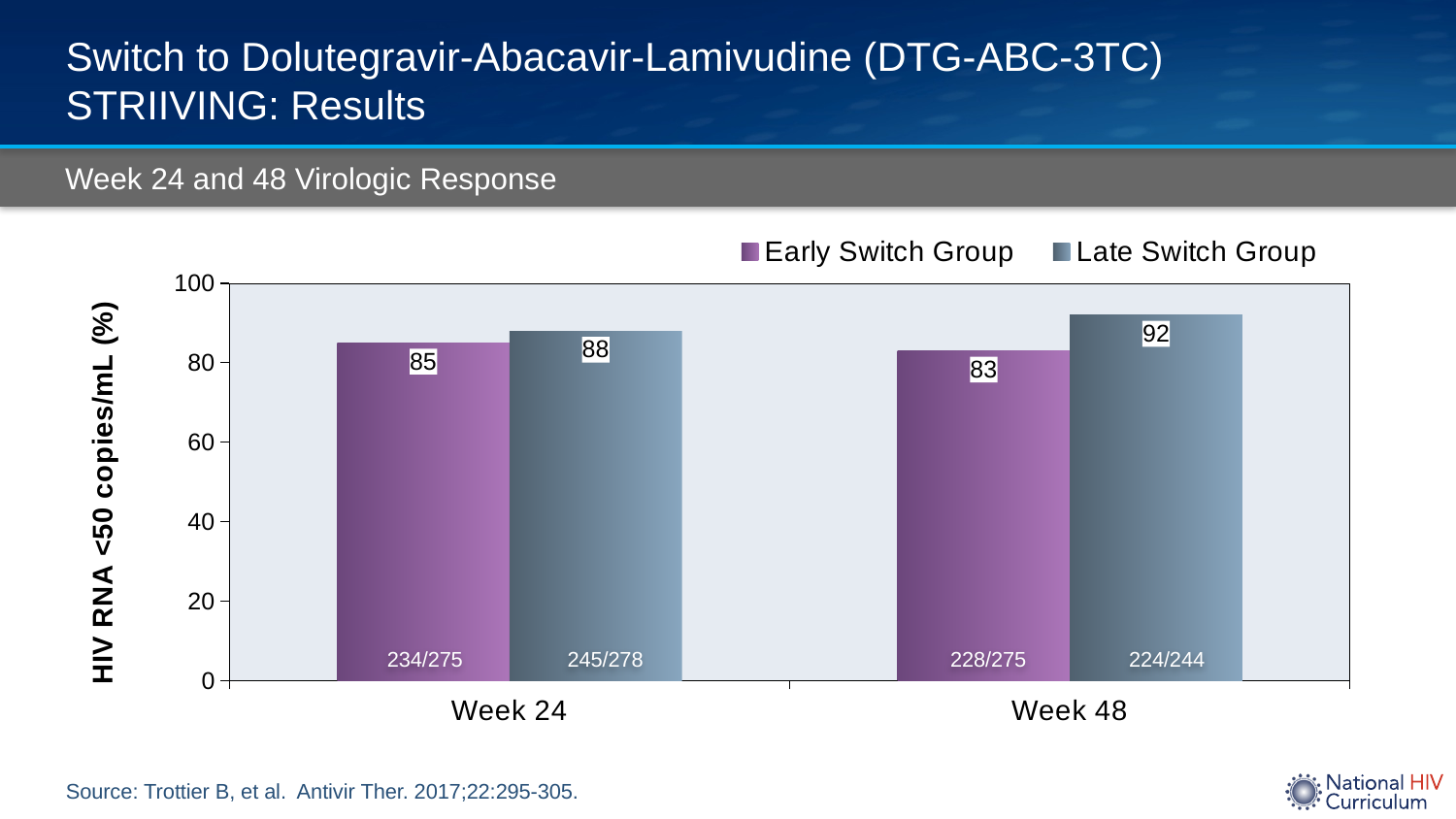
What is the difference between the Late Switch Group and the Early Switch Group at Week 24? 3 What is the value for the Early Switch Group at Week 48? 83 Which group has the highest value at Week 48? Late Switch Group What is the difference between the Late Switch Group and the Early Switch Group at Week 48? 9 How many categories are shown on the x axis? 2 What is the value for the Late Switch Group at Week 48? 92 What fraction is printed inside the Late Switch Group bar at Week 24? 245/278 What is the value for the Early Switch Group at Week 24? 85 How many series does the legend list? 2 What kind of chart is shown on the slide? Bar chart Which bar has the lowest value on the chart? Early Switch Group at Week 48 Which is larger at Week 24, the Early Switch Group or the Late Switch Group? Late Switch Group